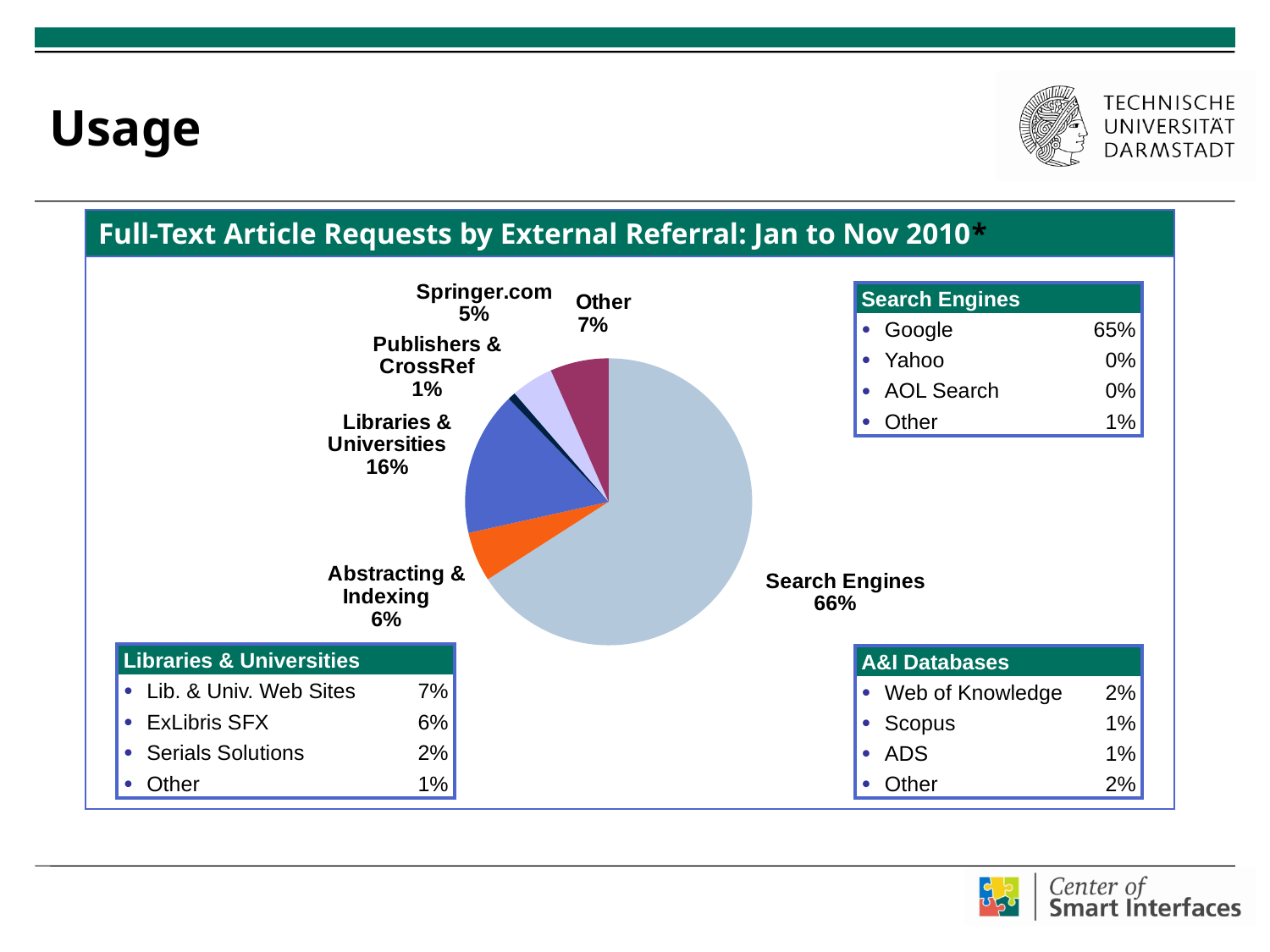
How many percentage points larger is the Search Engines share than the Libraries & Universities share? 50 What share of full-text article requests came from Abstracting & Indexing? 6% What share of full-text article requests came from Springer.com? 5% Which referral source has the smallest share of the pie? Publishers & CrossRef Which referral source has the largest share of the pie? Search Engines Which is larger, the share for Other or the share for Abstracting & Indexing? Other What kind of chart is shown on the slide? Pie chart What share of full-text article requests came from Search Engines? 66% What share of full-text article requests came from Libraries & Universities? 16% How many slices does the pie chart have? 6 What share of full-text article requests came from Publishers & CrossRef? 1% What is the title of the chart? Full-Text Article Requests by External Referral: Jan to Nov 2010